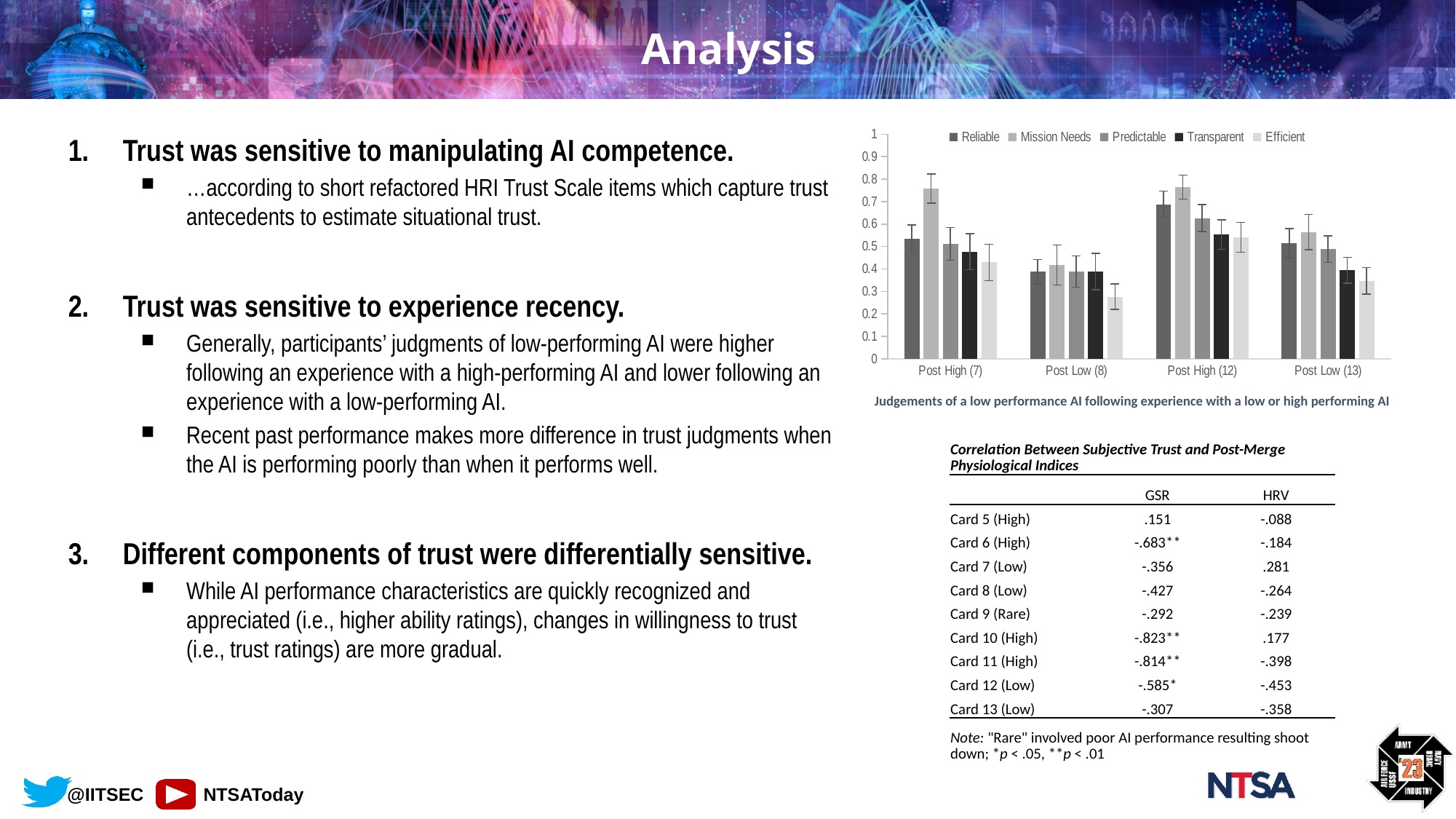
What is the first series listed in the legend of the bar chart? Reliable Which is larger: the Efficient value in Post High (12) or the Efficient value in Post Low (8)? Post High (12) How many categories are shown along the x axis of the bar chart? 4 What kind of chart is shown on the slide? bar chart Within the Post Low (8) group, which series has the lowest value? Efficient How many series does the legend of the bar chart list? 5 Is the value for Efficient in the Post Low (8) group greater or less than 0.3? less Within the Post High (7) group, which series has the highest value? Mission Needs Is the value for Transparent in the Post Low (13) group greater or less than 0.5? less Is the value for Mission Needs in the Post High (7) group greater or less than 0.7? greater Which is larger: the Mission Needs value in Post High (7) or the Mission Needs value in Post Low (13)? Post High (7)